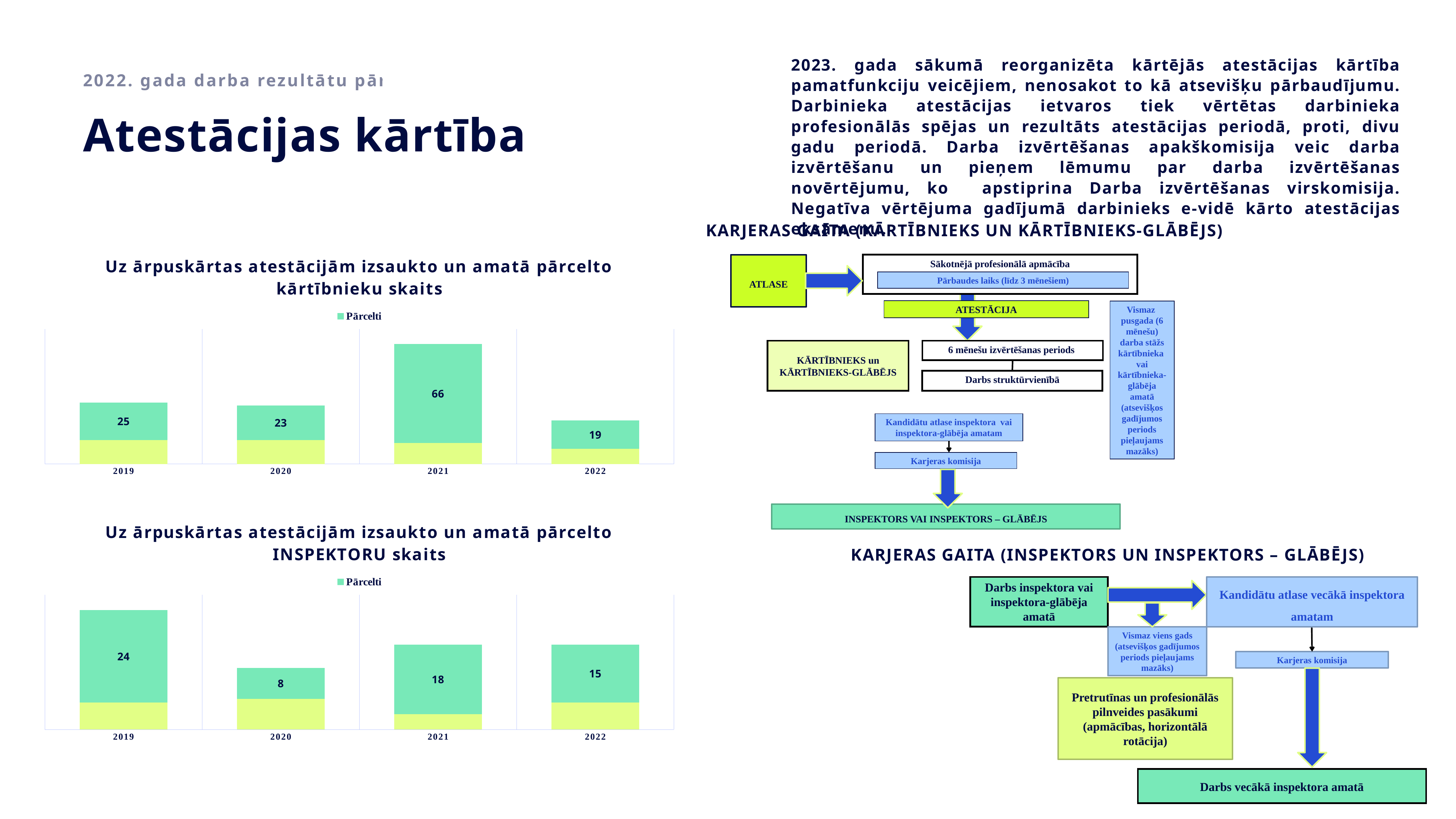
In the bottom-left chart (INSPEKTORU skaits), which year has the highest Pārcelti value? 2019 What kind of chart is the bottom-left chart (INSPEKTORU skaits)? Bar chart In the top-left chart (kārtībnieku skaits), which year has the highest Pārcelti value? 2021 In the top-left chart (kārtībnieku skaits), what is the difference between the Pārcelti values for 2021 and 2020? 43 In the bottom-left chart (INSPEKTORU skaits), which year has the lowest Pārcelti value? 2020 In the bottom-left chart (INSPEKTORU skaits), which year has the larger Pārcelti value, 2021 or 2022? 2021 In the top-left chart (kārtībnieku skaits), what is the Pārcelti value for 2021? 66 In the top-left chart (kārtībnieku skaits), what is the Pārcelti value for 2022? 19 How many years are shown on the x axis of the top-left chart (kārtībnieku skaits)? 4 In the bottom-left chart (INSPEKTORU skaits), what is the Pārcelti value for 2020? 8 In the top-left chart (kārtībnieku skaits), which year has the lowest Pārcelti value? 2022 In the bottom-left chart (INSPEKTORU skaits), what is the difference between the Pārcelti values for 2019 and 2022? 9